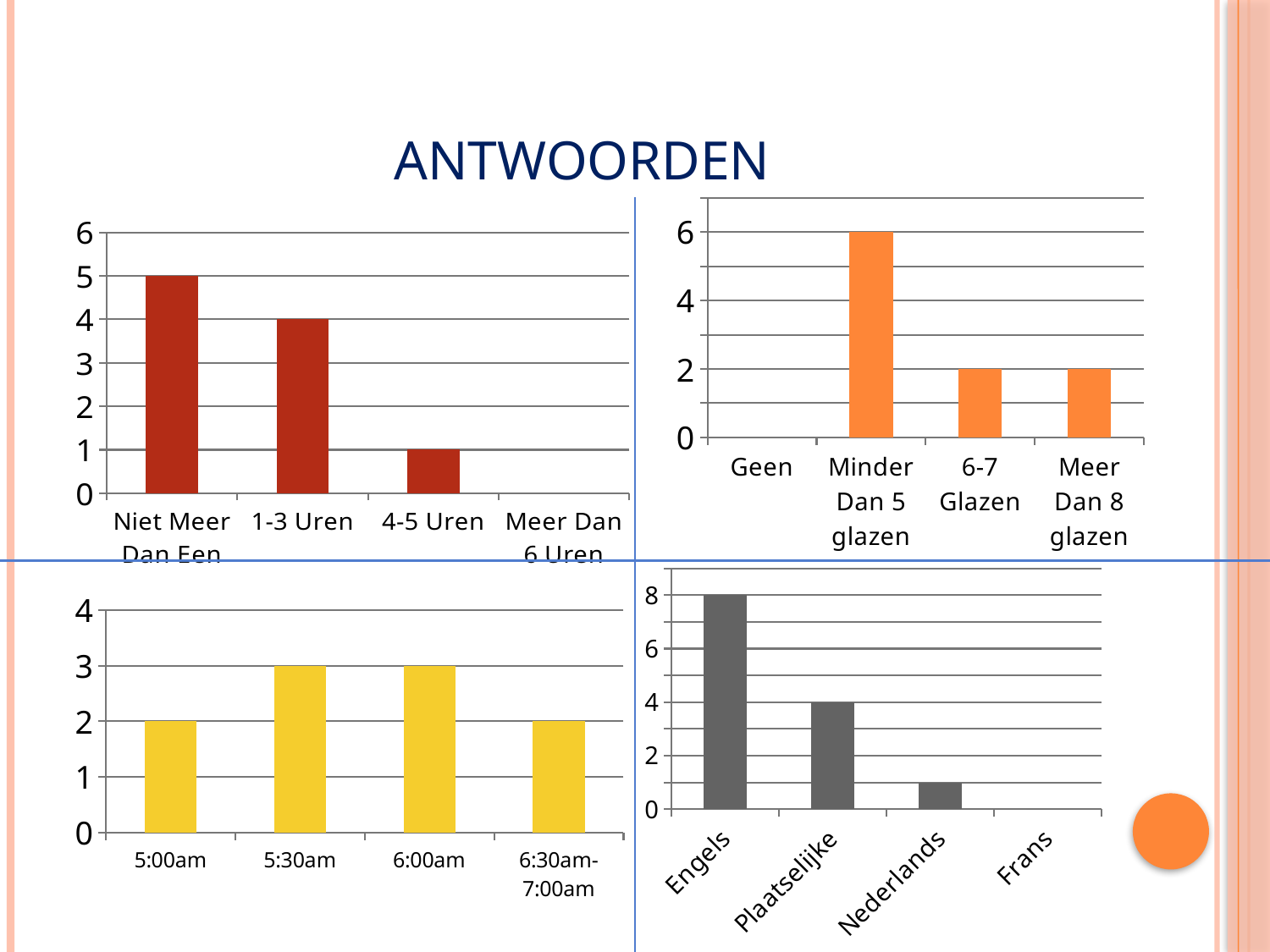
In the top-left chart, what is the value for 1-3 Uren? 4 In the top-right chart, which is larger, the value for Minder Dan 5 glazen or the value for 6-7 Glazen? Minder Dan 5 glazen In the bottom-right chart, what is the value for Engels? 8 In the bottom-left chart, what is the total of the values for 5:00am and 6:30am-7:00am? 4 In the bottom-right chart, is the value for Nederlands greater or less than 2? less In the bottom-left chart, what is the value for 5:30am? 3 In the top-right chart, how many categories are shown on the x axis? 4 What kind of chart is the bottom-left chart? bar chart In the top-right chart, what is the value for Minder Dan 5 glazen? 6 In the bottom-right chart, do the values rise or fall from Engels to Frans along the x axis? fall In the top-left chart, which category has the highest value? Niet Meer Dan Een In the top-left chart, what is the difference between the values for Niet Meer Dan Een and 4-5 Uren? 4